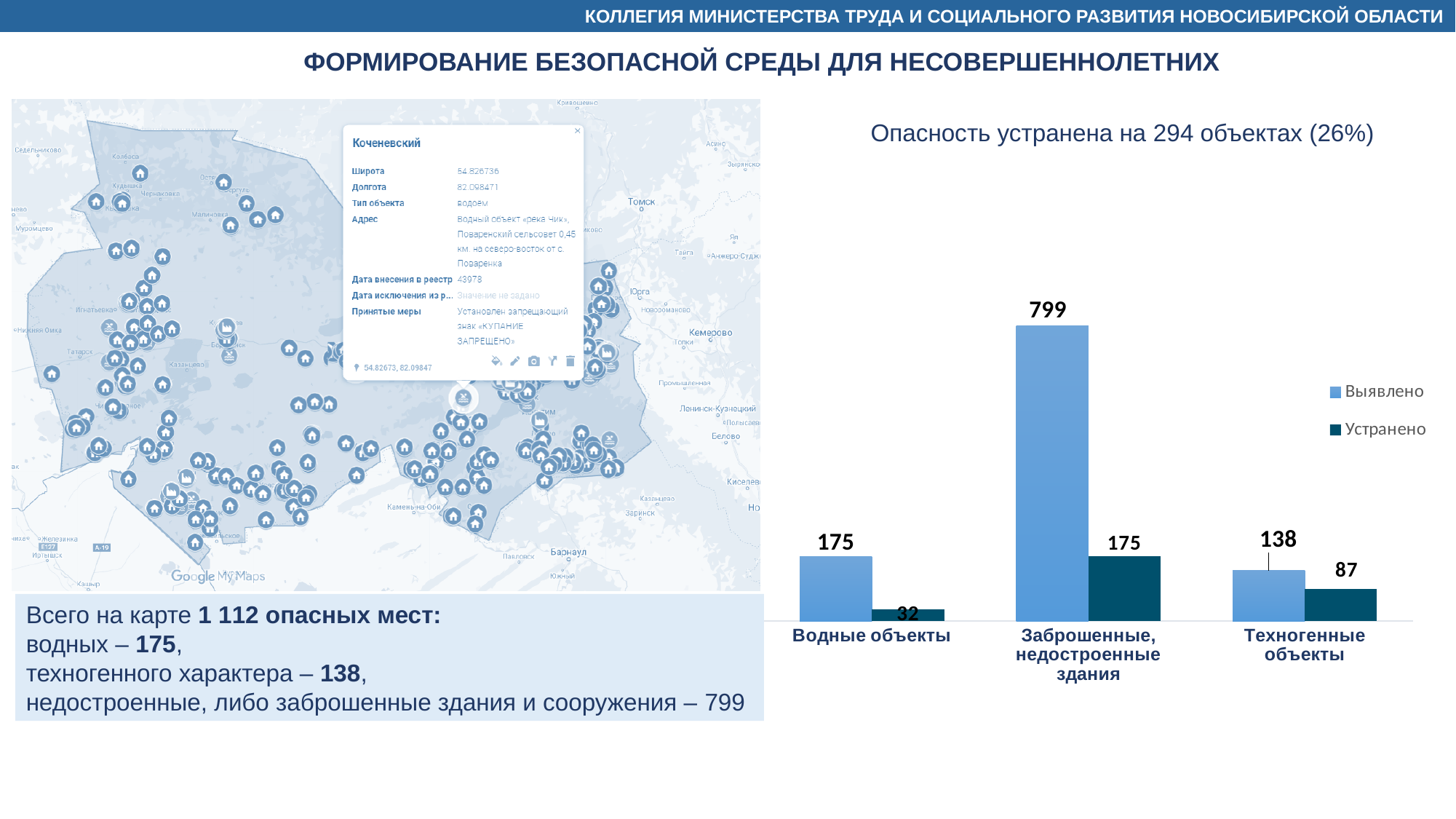
Which is larger: the 'Выявлено' value for 'Водные объекты' or for 'Техногенные объекты'? Водные объекты Which category has the highest 'Выявлено' value? Заброшенные, недостроенные здания What is the 'Устранено' value for 'Водные объекты'? 32 What is the 'Выявлено' value for 'Заброшенные, недостроенные здания'? 799 Which category has the lowest 'Устранено' value? Водные объекты What kind of chart is shown on the slide? Bar chart How many categories are shown on the x axis of the chart? 3 What are the two series named in the chart legend? Выявлено and Устранено How many series does the chart legend list? 2 What is the difference between 'Выявлено' and 'Устранено' for 'Заброшенные, недостроенные здания'? 624 What is the 'Выявлено' value for 'Водные объекты'? 175 What is the 'Устранено' value for 'Техногенные объекты'? 87